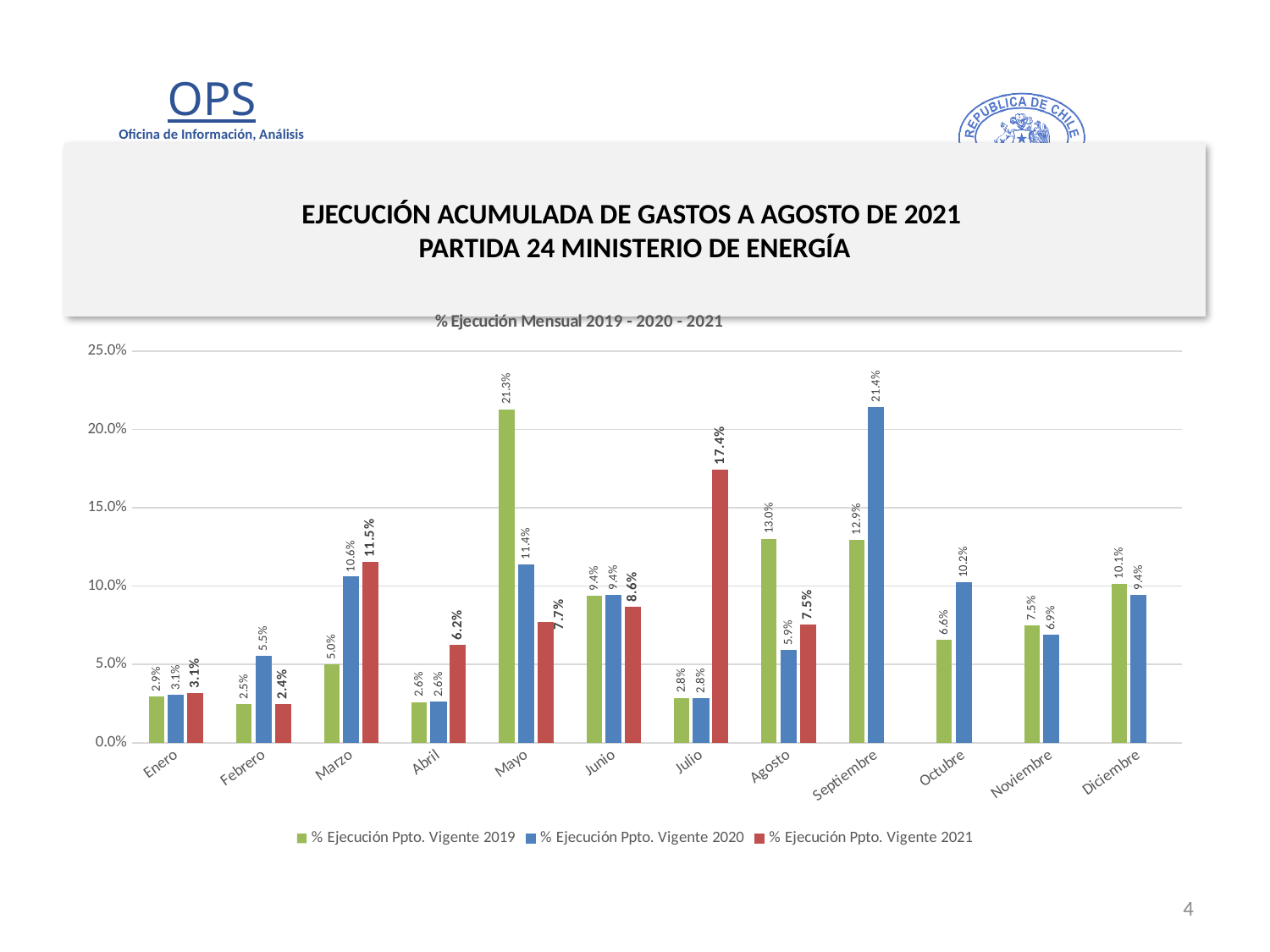
What is the value for % Ejecución Ppto. Vigente 2020 in Septiembre? 21.4% What is the value for % Ejecución Ppto. Vigente 2019 in Mayo? 21.3% What is the value for % Ejecución Ppto. Vigente 2021 in Julio? 17.4% In Agosto, which is larger: the 2019 value or the 2020 value? 2019 What is the title of the chart? % Ejecución Mensual 2019 - 2020 - 2021 Is the value for % Ejecución Ppto. Vigente 2020 in Octubre greater or less than 10.0%? greater How many months are shown on the x axis? 12 What kind of chart is shown on the slide? Bar chart What is the difference between the 2021 and 2019 values in Marzo? 6.5% Which month has the highest value for % Ejecución Ppto. Vigente 2021? Julio Which month has the lowest value for % Ejecución Ppto. Vigente 2019? Febrero How many series does the legend list? 3